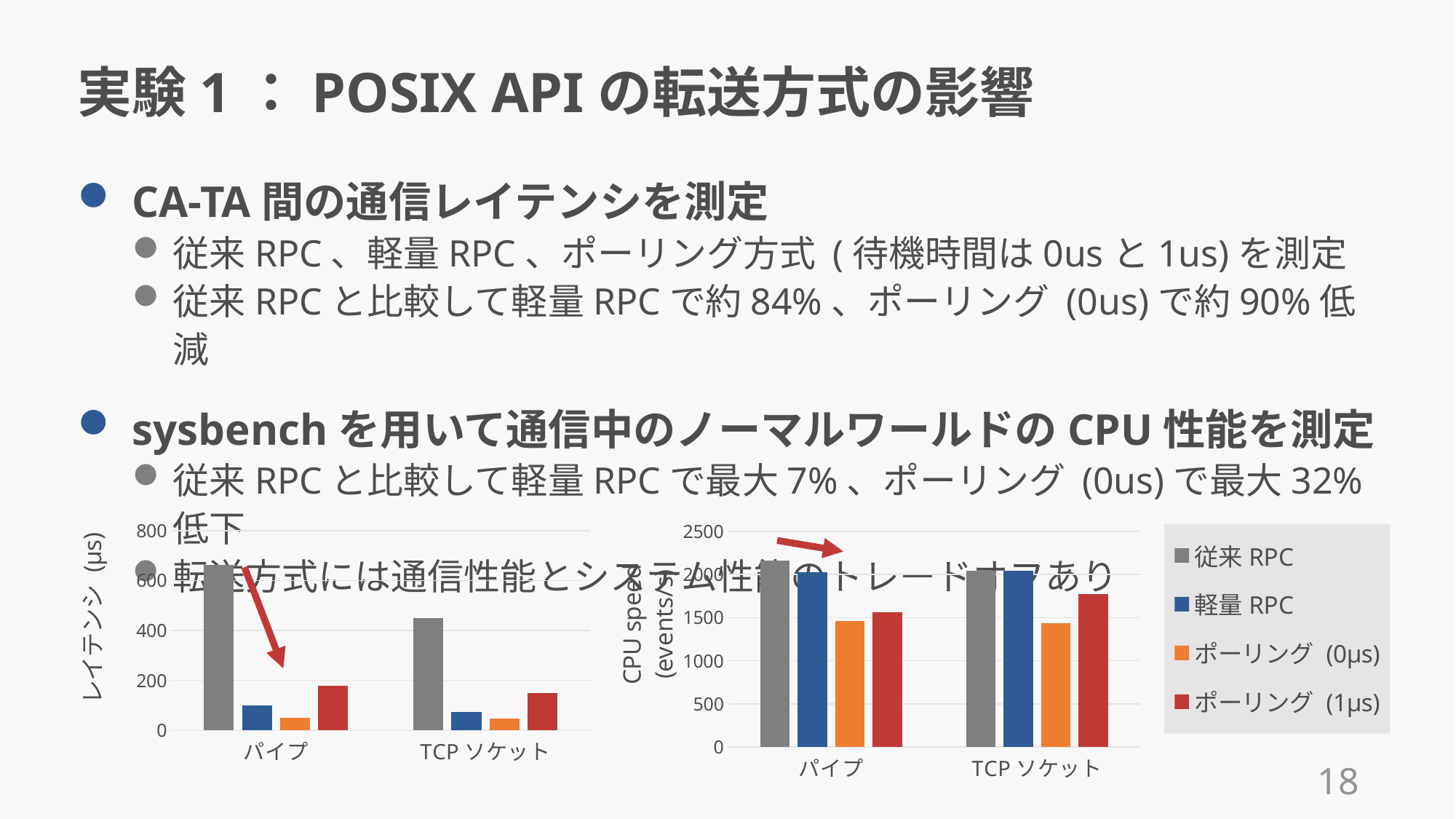
In the right chart (CPU speed), is the value of ポーリング (1µs) for TCP ソケット greater or less than 2000? less In the left chart (レイテンシ), is the 従来 RPC value larger for パイプ or for TCP ソケット? パイプ What kind of chart is the left chart (レイテンシ)? bar chart In the right chart (CPU speed), which series has the lowest value for パイプ? ポーリング (0µs) In the left chart (レイテンシ), is the value of 従来 RPC for パイプ greater or less than 600? greater In the right chart (CPU speed), is the value of 従来 RPC for パイプ greater or less than 2000? greater How many series does the legend list? 4 In the left chart (レイテンシ), how many categories are shown on the x axis? 2 In the left chart (レイテンシ), which series has the lowest value for パイプ? ポーリング (0µs) What is the y-axis label of the left chart? レイテンシ (µs) In the left chart (レイテンシ), which series has the highest value for パイプ? 従来 RPC